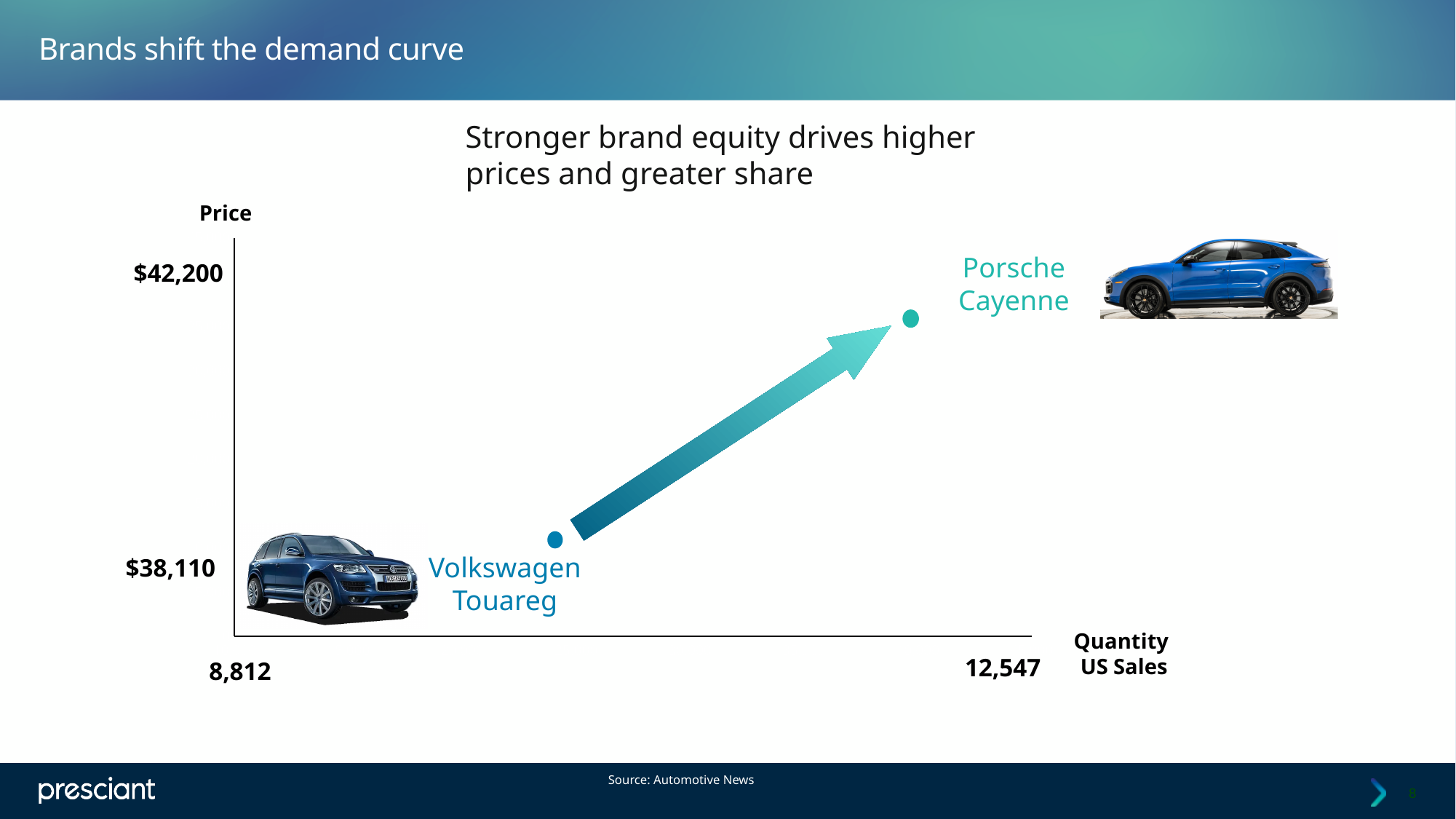
What US sales quantity is shown for the Porsche Cayenne? 12,547 Which vehicle has the higher price on the chart? Porsche Cayenne Is the Porsche Cayenne's US sales quantity larger or smaller than the Volkswagen Touareg's? larger What is the difference in price between the Porsche Cayenne and the Volkswagen Touareg? $4,090 What US sales quantity is shown for the Volkswagen Touareg? 8,812 How many vehicles are plotted on the chart? 2 What is the label of the horizontal axis of the chart? Quantity US Sales What is the label of the vertical axis of the chart? Price What is the price shown for the Porsche Cayenne? $42,200 What is the difference in US sales quantity between the Porsche Cayenne and the Volkswagen Touareg? 3,735 Which vehicle has the lower US sales quantity on the chart? Volkswagen Touareg What is the price shown for the Volkswagen Touareg? $38,110